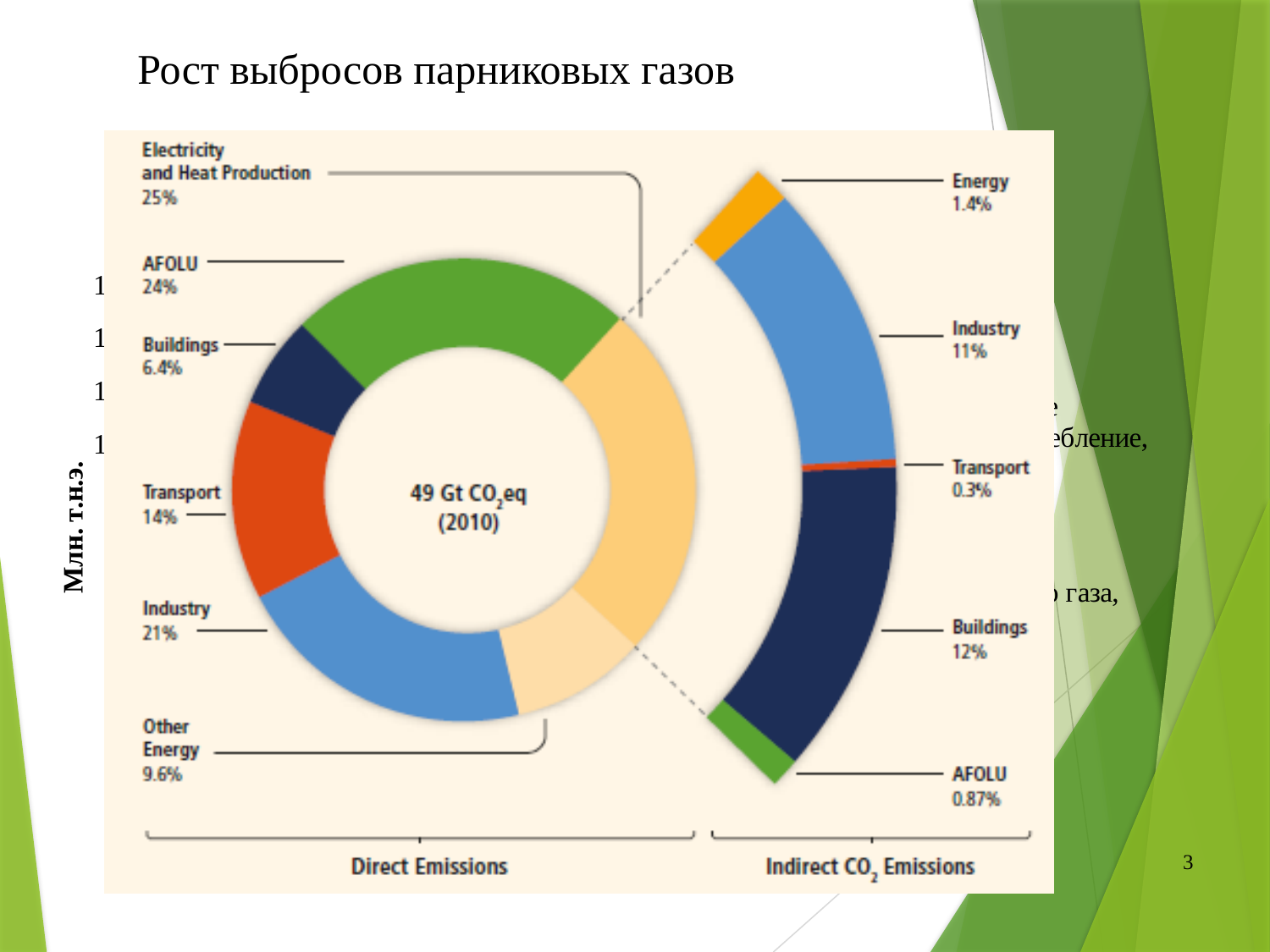
What share of indirect CO2 emissions is attributed to Buildings? 12% Which indirect CO2 emissions sector has the smallest share? Transport Which direct emissions sector has the smallest share? Buildings What share of indirect CO2 emissions comes from Transport? 0.3% What kind of chart is shown on the slide? Pie (donut) chart What share of direct emissions comes from Electricity and Heat Production? 25% Which direct emissions sector has the largest share? Electricity and Heat Production What share of direct emissions is attributed to AFOLU? 24% What share of direct emissions comes from Transport? 14% What is the difference between the direct emissions shares of Industry and Other Energy? 11.4% Which is larger: the indirect CO2 emissions share of Industry or of Buildings? Buildings What total amount of emissions is shown in the centre of the chart? 49 Gt CO2eq (2010)